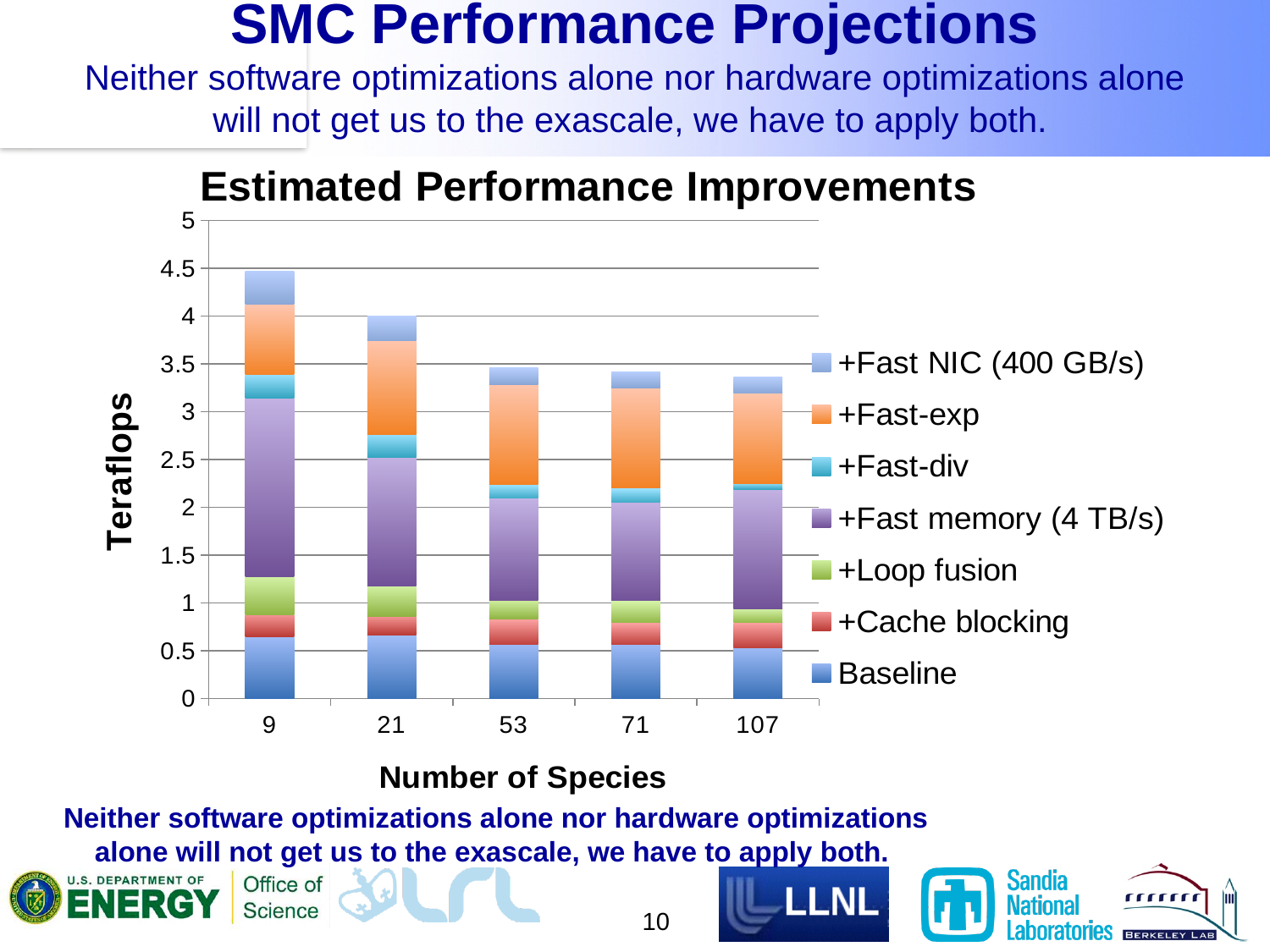
Is the total stacked value for 9 species greater or less than 4 Teraflops? greater Is the total stacked value for 53 species greater or less than 4 Teraflops? less How many series does the legend list? 7 Do the total stacked bar heights generally rise or fall as the number of species increases along the x axis? fall Is the total stacked value for 107 species greater or less than 4 Teraflops? less What is the label of the y axis? Teraflops What kind of chart is shown on the slide? stacked bar chart Which has the larger total stacked bar, 9 species or 53 species? 9 Which number of species has the highest total stacked bar? 9 What is the title of the chart? Estimated Performance Improvements How many categories (numbers of species) are shown on the x axis? 5